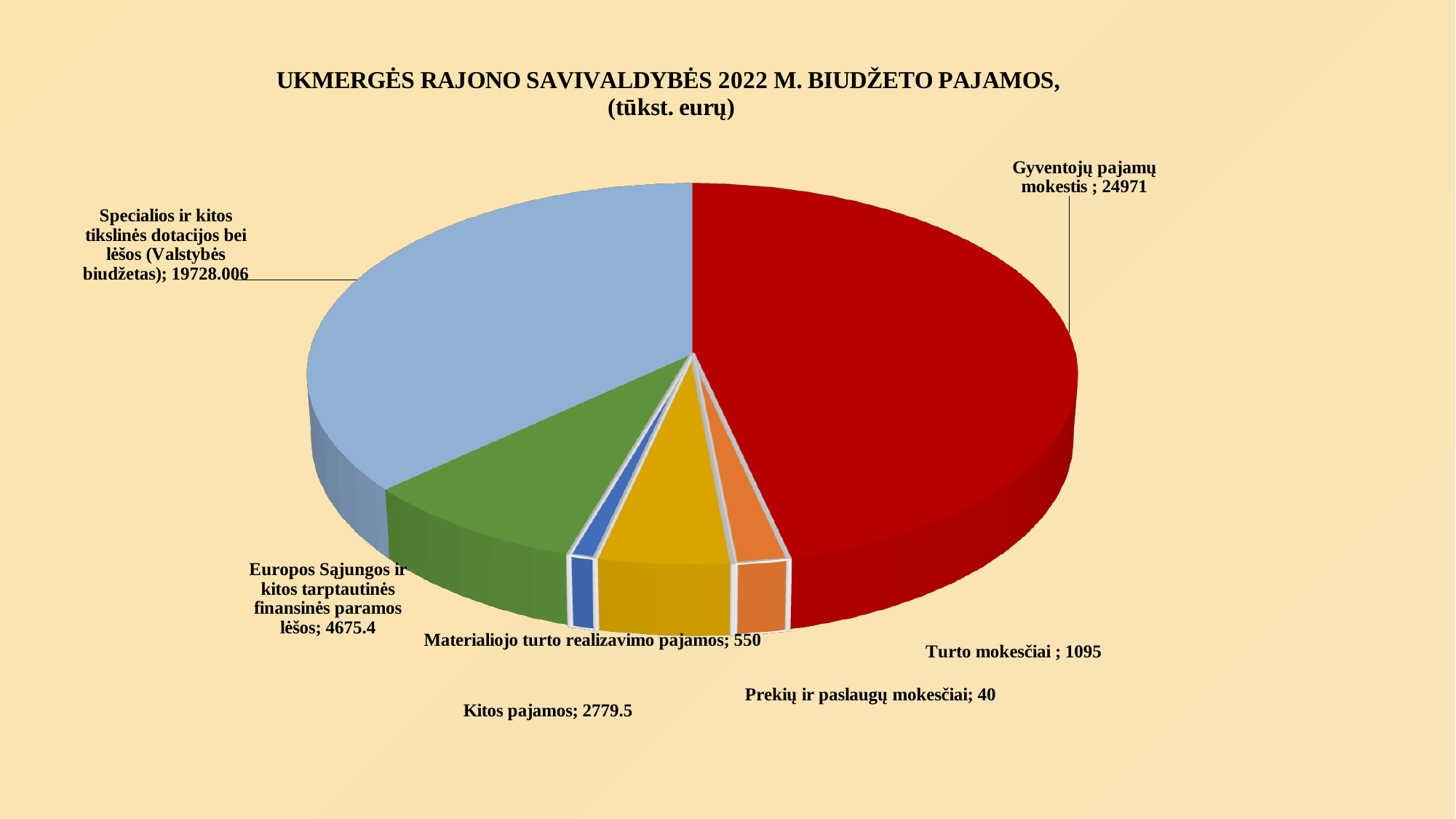
What is the difference between Gyventojų pajamų mokestis and Specialios ir kitos tikslinės dotacijos bei lėšos (Valstybės biudžetas)? 5242.994 How many categories (slices) does the pie chart have? 7 What is the value for Europos Sąjungos ir kitos tarptautinės finansinės paramos lėšos? 4675.4 What is the value for Specialios ir kitos tikslinės dotacijos bei lėšos (Valstybės biudžetas)? 19728.006 What is the difference between Turto mokesčiai and Prekių ir paslaugų mokesčiai? 1055 What is the value for Gyventojų pajamų mokestis? 24971 Which category has the largest slice of the pie? Gyventojų pajamų mokestis Which category has the smallest slice of the pie? Prekių ir paslaugų mokesčiai What is the value for Prekių ir paslaugų mokesčiai? 40 Which is larger, Kitos pajamos or Materialiojo turto realizavimo pajamos? Kitos pajamos What unit is stated in the chart title? tūkst. eurų What kind of chart is shown on the slide? pie chart